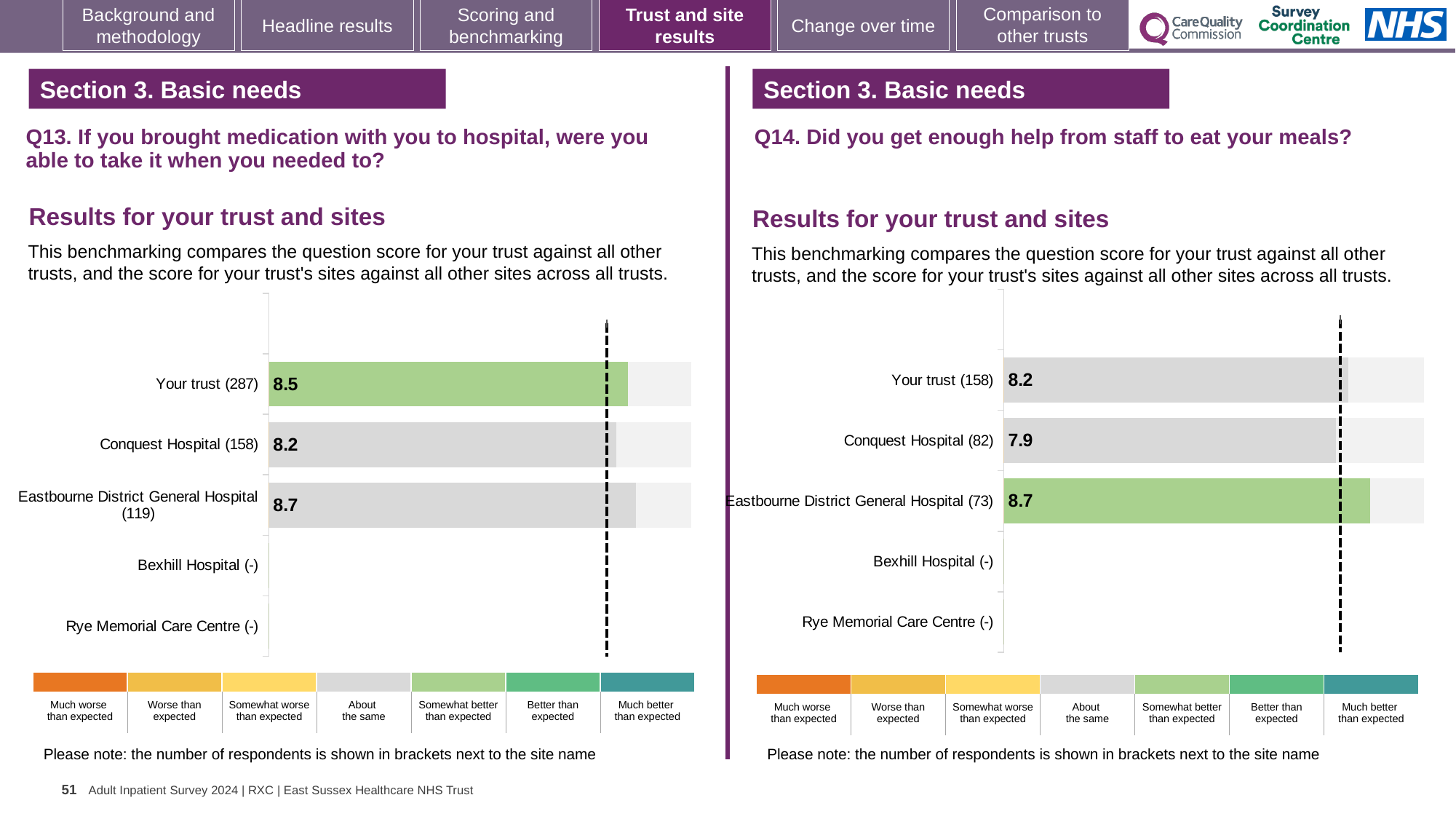
On the Q14 chart (right), which row has the lowest score? Conquest Hospital On the Q13 chart (left), what is the difference between the scores for Eastbourne District General Hospital and Conquest Hospital? 0.5 On the Q13 chart (left), what is the score for Your trust? 8.5 On the Q14 chart (right), what is the score for Eastbourne District General Hospital? 8.7 On the Q14 chart (right), what is the score for Conquest Hospital? 7.9 On the Q13 chart (left), how many respondents are shown in brackets for Your trust? 287 What kind of chart is used on the Q14 chart (right)? bar chart On the Q13 chart (left), how many rows (sites and trust) are listed on the vertical axis? 5 On the Q13 chart (left), which site or trust row has the highest score? Eastbourne District General Hospital On the Q13 chart (left), what is the score for Conquest Hospital? 8.2 On the Q14 chart (right), what is the difference between the scores for Your trust and Conquest Hospital? 0.3 On the Q14 chart (right), is the score for Your trust larger or smaller than the score for Eastbourne District General Hospital? smaller